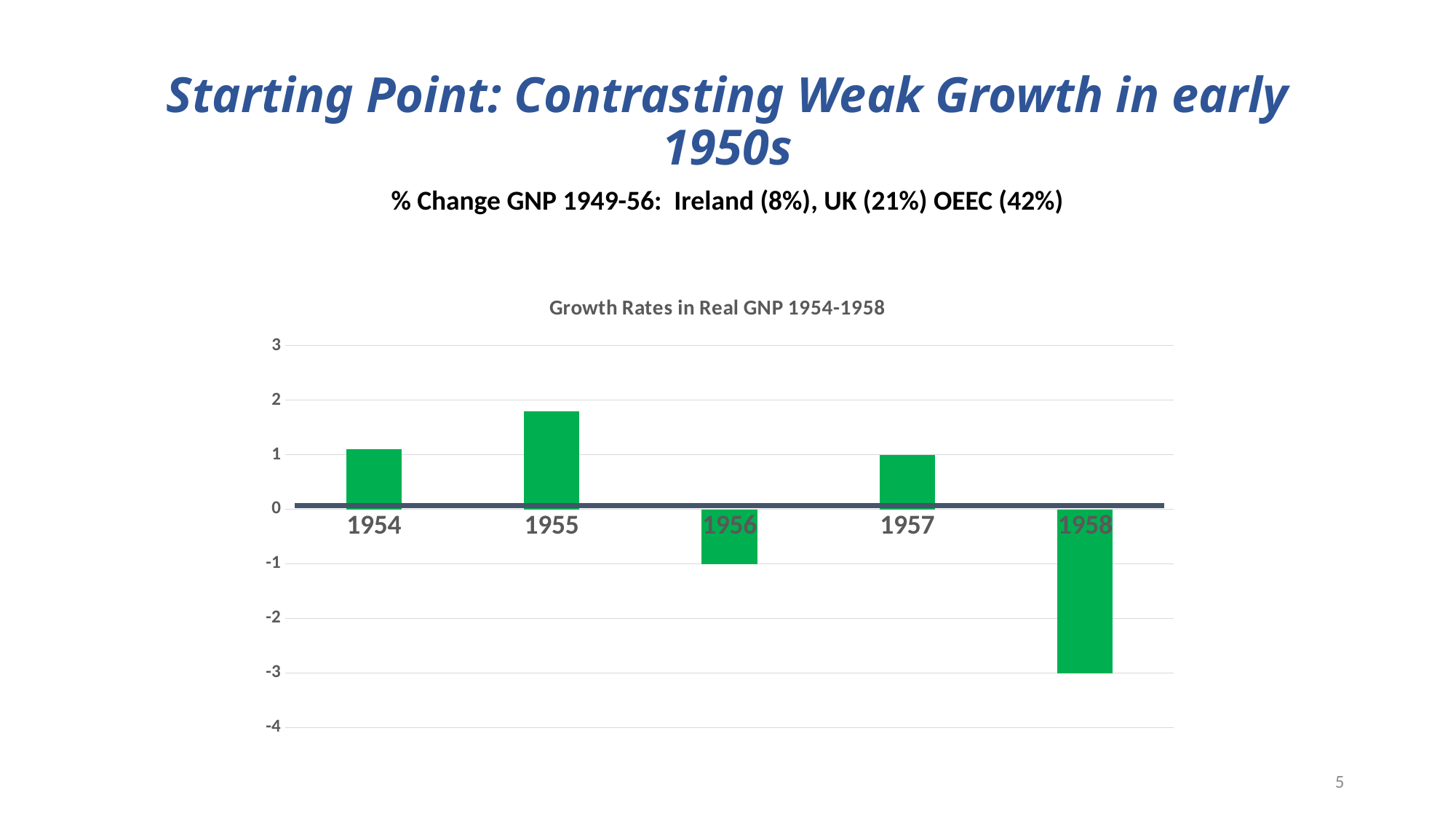
What kind of chart is shown on the slide? bar chart Is the value for 1955 greater or less than 2? less Which year has the highest growth rate in the chart? 1955 How many years are plotted in the chart? 5 Which year has the larger growth rate, 1954 or 1955? 1955 Which year has the lowest growth rate in the chart? 1958 What is the growth rate value for 1956? -1 What is the growth rate value for 1958? -3 Is the value for 1958 greater or less than -2? less What is the title of the chart? Growth Rates in Real GNP 1954-1958 What is the difference between the values for 1957 and 1958? 4 What is the growth rate value for 1957? 1